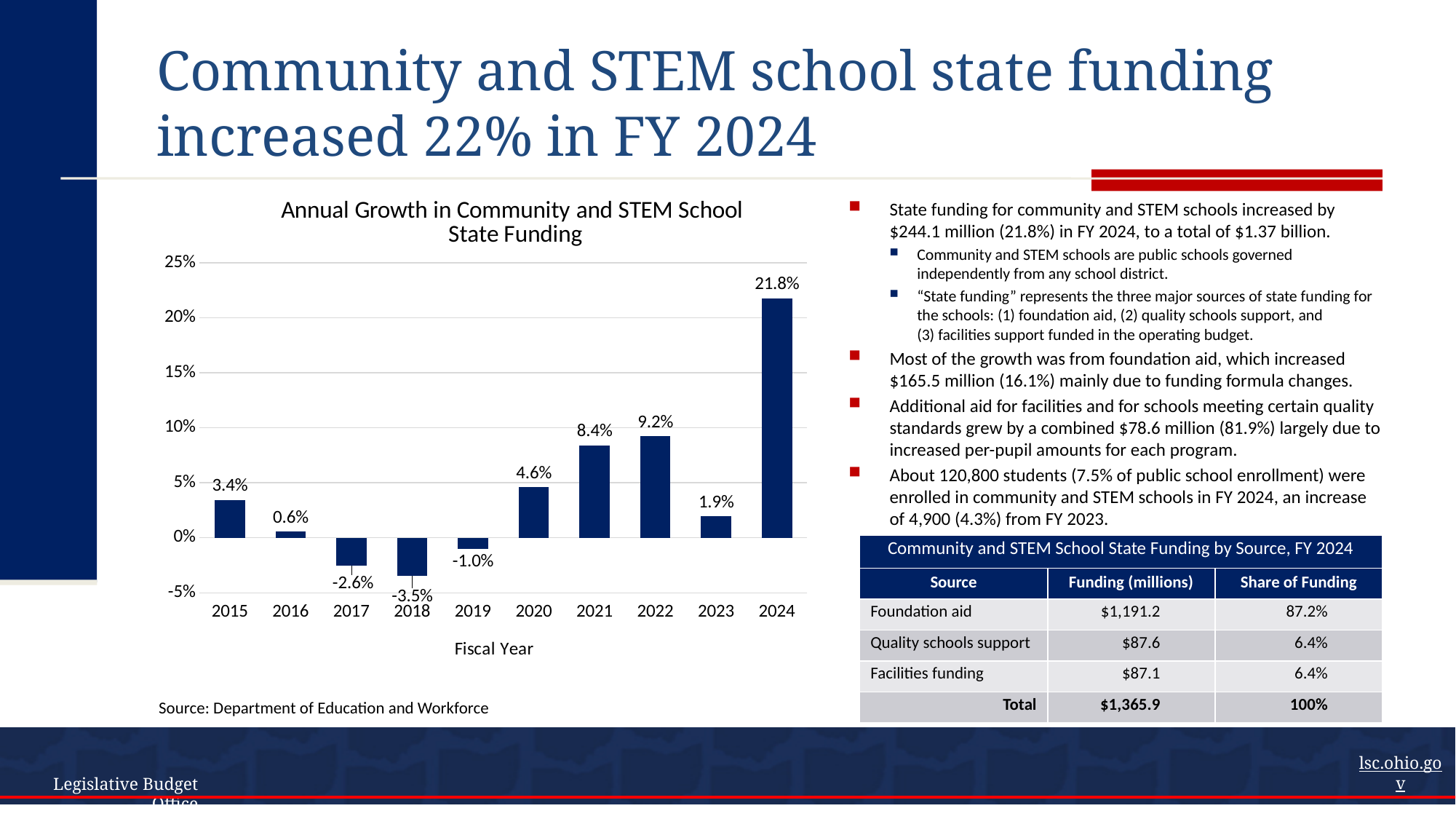
How many fiscal years are shown on the x axis of the chart? 10 How many fiscal years in the chart show negative annual growth? 3 What kind of chart is used to show annual growth in community and STEM school state funding? Bar chart Which fiscal year has the highest annual growth in the chart? 2024 Which fiscal year had higher annual growth, 2021 or 2023? 2021 Is the annual growth value for 2024 greater or less than 20%? greater What is the difference between the annual growth in 2024 and in 2022? 12.6 percentage points Which fiscal year has the lowest annual growth in the chart? 2018 What is the annual growth value shown for fiscal year 2022? 9.2% What is the annual growth in community and STEM school state funding for fiscal year 2024? 21.8% What is the title of the chart on the slide? Annual Growth in Community and STEM School State Funding What is the annual growth value shown for fiscal year 2018? -3.5%